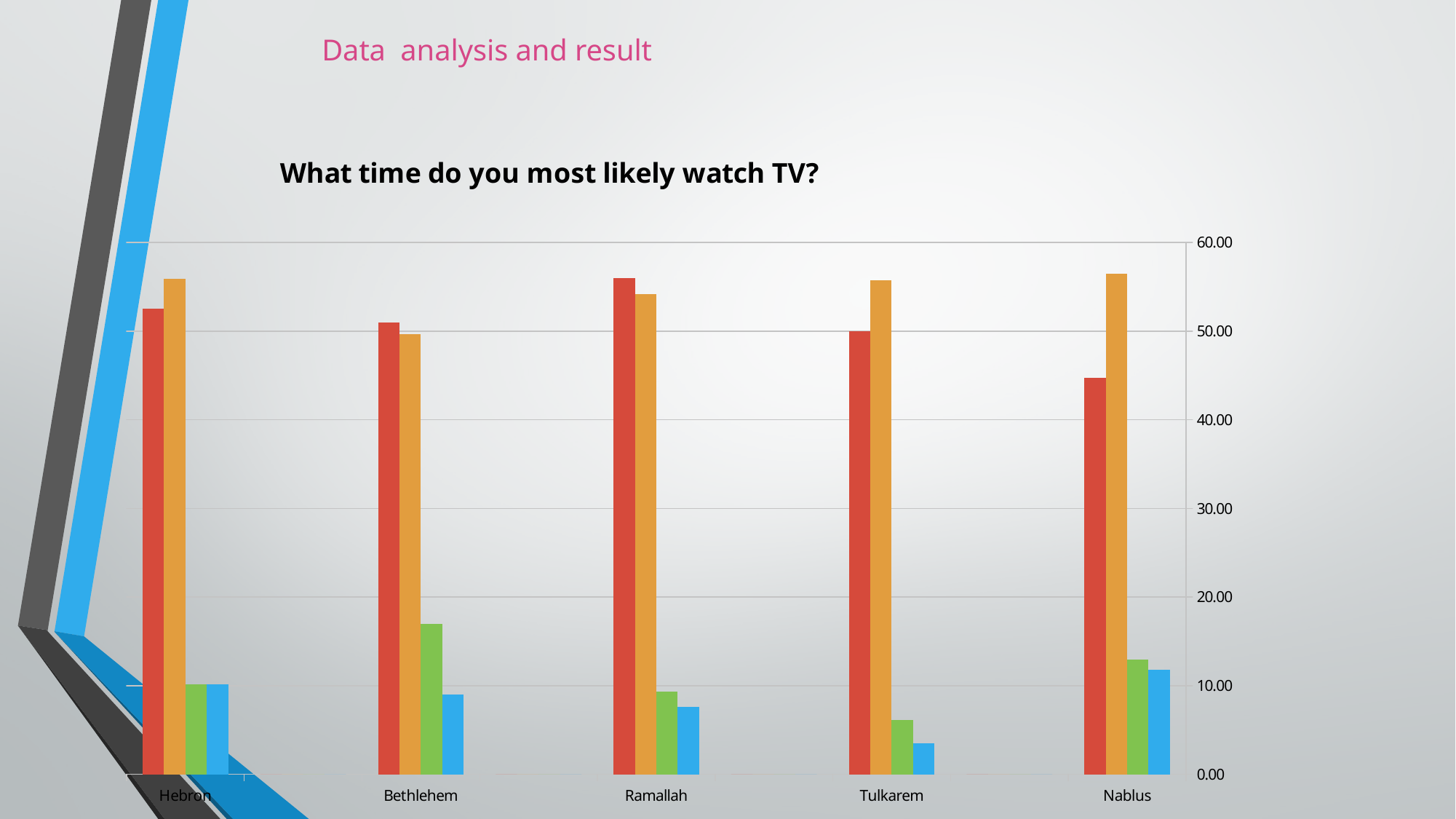
For Bethlehem, which is larger: the green bar or the blue bar? the green bar How many bars are plotted for each city in the chart? 4 Is the value of the orange bar for Hebron greater or less than 50.00? greater Which city has the lowest blue bar? Tulkarem Is the value of the blue bar for Tulkarem greater or less than 10.00? less Is the value of the red bar for Nablus greater or less than 50.00? less Which city has the highest green bar? Bethlehem For Nablus, which is larger: the red bar or the orange bar? the orange bar How many cities are shown on the x axis of the chart? 5 What is the title of the chart? What time do you most likely watch TV? What kind of chart is shown on the slide? bar chart